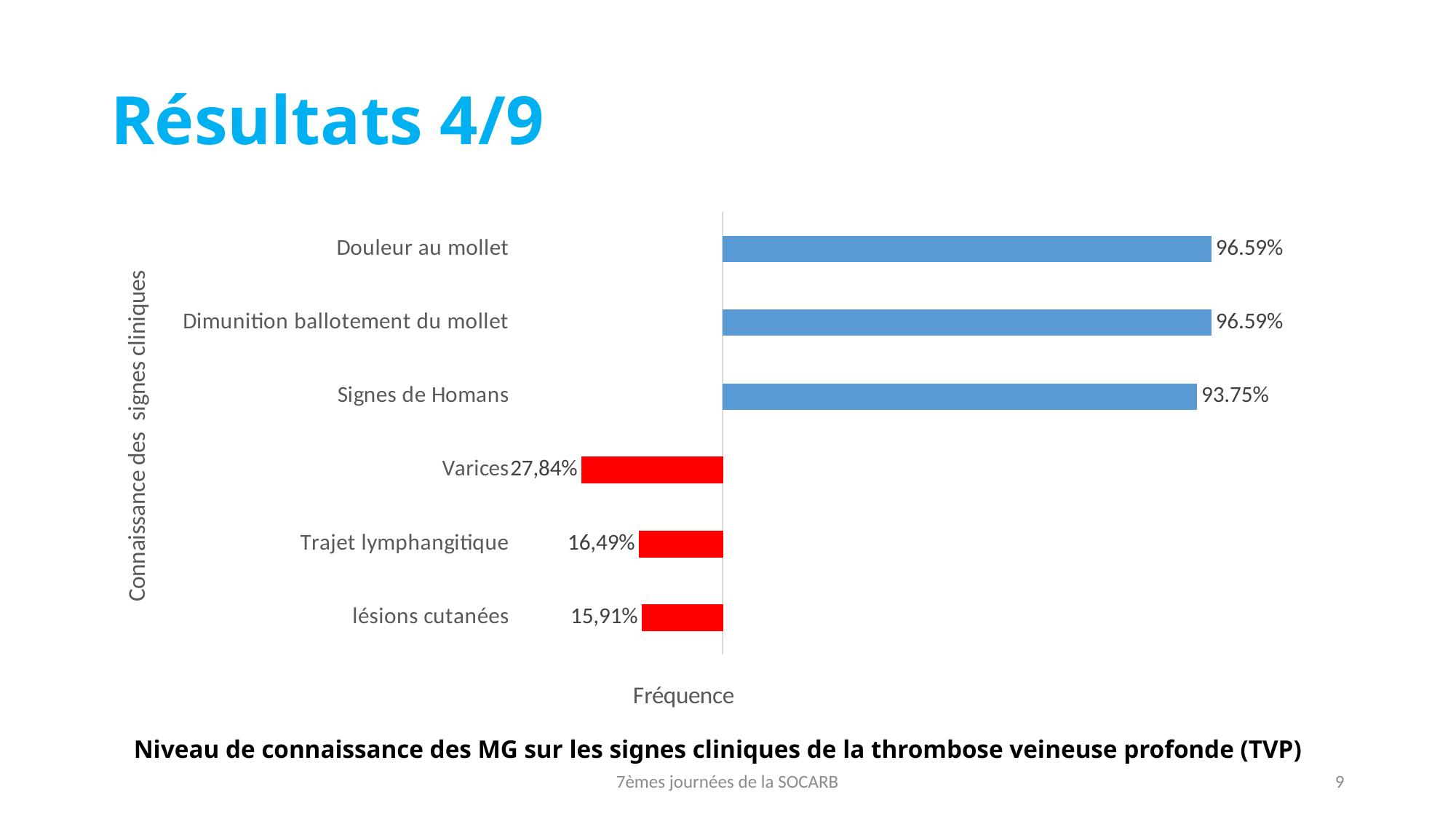
What is the value shown for Douleur au mollet? 96.59% Which category has the lowest value? lésions cutanées What is the value shown for Signes de Homans? 93.75% Which has a larger value, Signes de Homans or Varices? Signes de Homans What is the difference between the values for Douleur au mollet and Signes de Homans? 2.84 percentage points What kind of chart is shown on the slide? Bar chart How many categories are shown in the chart? 6 What is the title of the horizontal axis of the chart? Fréquence What is the difference between the values for Varices and lésions cutanées? 11,93 percentage points What is the value shown for lésions cutanées? 15,91% What is the value shown for Trajet lymphangitique? 16,49% What is the value shown for Varices? 27,84%